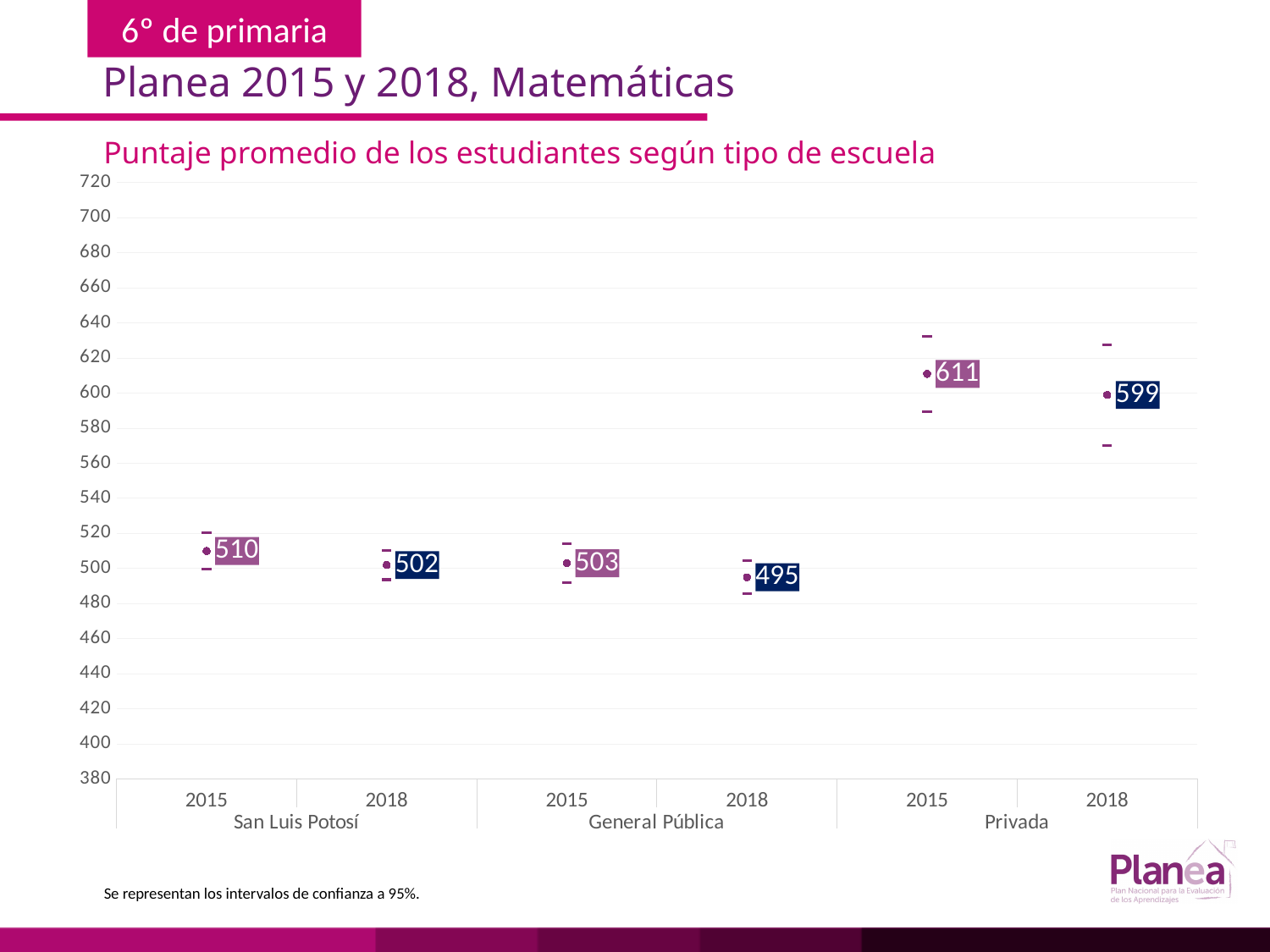
What is the difference between the San Luis Potosí score in 2015 and the General Pública score in 2015? 7 What is the average score for Privada in 2015? 611 What is the title of the chart? Puntaje promedio de los estudiantes según tipo de escuela Which school type and year has the highest average score? Privada 2015 Did the average score for San Luis Potosí rise or fall from 2015 to 2018? fall Which is larger, the San Luis Potosí score in 2018 or the General Pública score in 2018? San Luis Potosí 2018 What is the average score for General Pública in 2015? 503 How many data points are plotted on the chart? 6 Is the value for Privada in 2018 greater or less than 580? greater What is the average score for San Luis Potosí in 2018? 502 What is the difference between the Privada scores in 2015 and 2018? 12 Which school type and year has the lowest average score? General Pública 2018